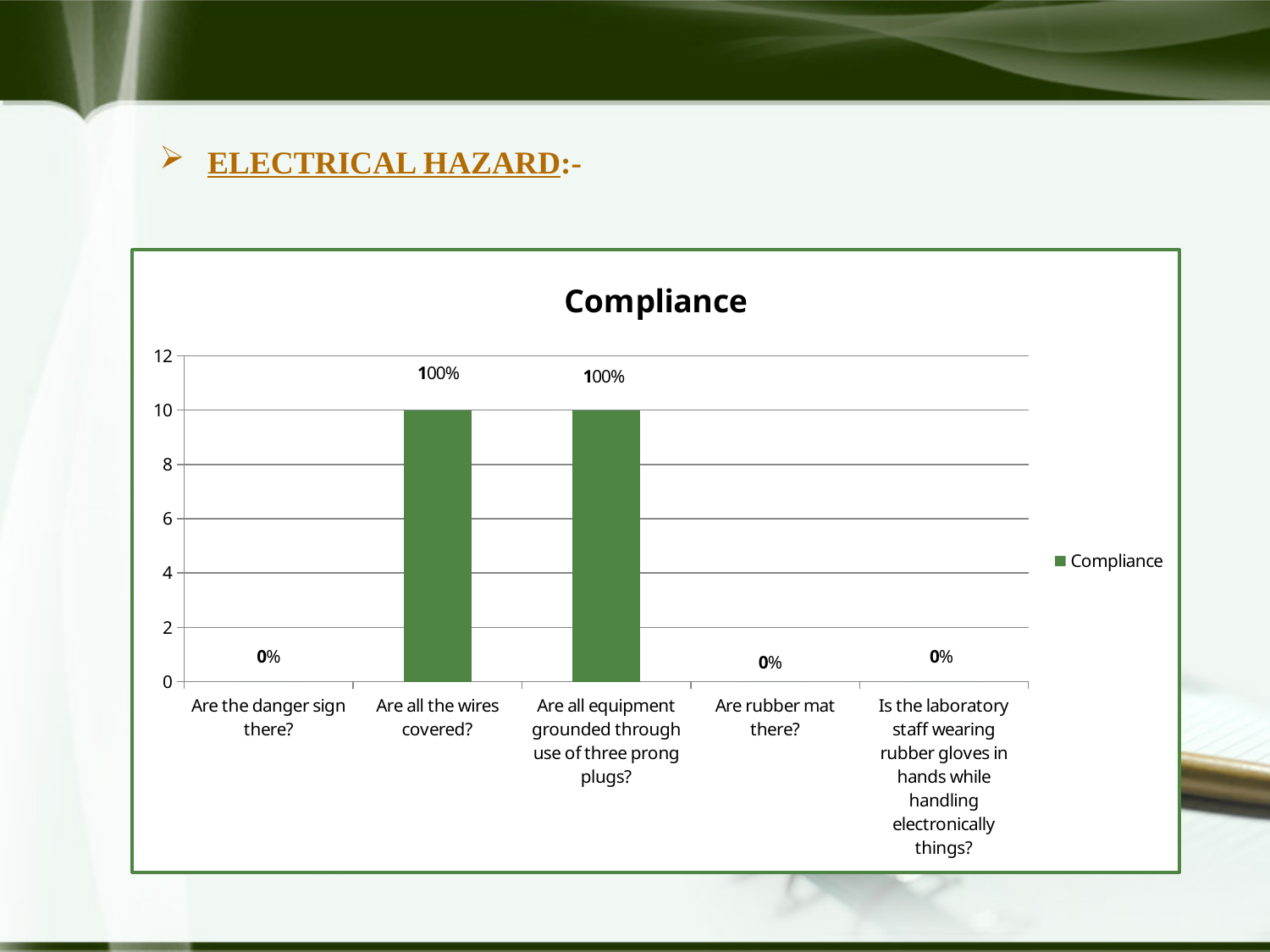
What is the data label shown for "Are rubber mat there?" in the Compliance chart? 0% What is the title of the chart on the slide? Compliance Which has the larger value in the Compliance chart: "Are all the wires covered?" or "Are rubber mat there?" Are all the wires covered? What is the data label shown for "Are all the wires covered?" in the Compliance chart? 100% What is the data label shown for "Are the danger sign there?" in the Compliance chart? 0% In the Compliance chart, is the bar for "Are all the wires covered?" greater or less than 8 on the y axis? greater How many series does the legend of the Compliance chart list? 1 What kind of chart is the Compliance chart? Bar chart What is the data label shown for "Are all equipment grounded through use of three prong plugs?" in the Compliance chart? 100% How many categories are shown on the x axis of the Compliance chart? 5 What is the difference between the data labels for "Are all equipment grounded through use of three prong plugs?" and "Are the danger sign there?" in the Compliance chart? 100% What is the data label shown for "Is the laboratory staff wearing rubber gloves in hands while handling electronically things?" in the Compliance chart? 0%